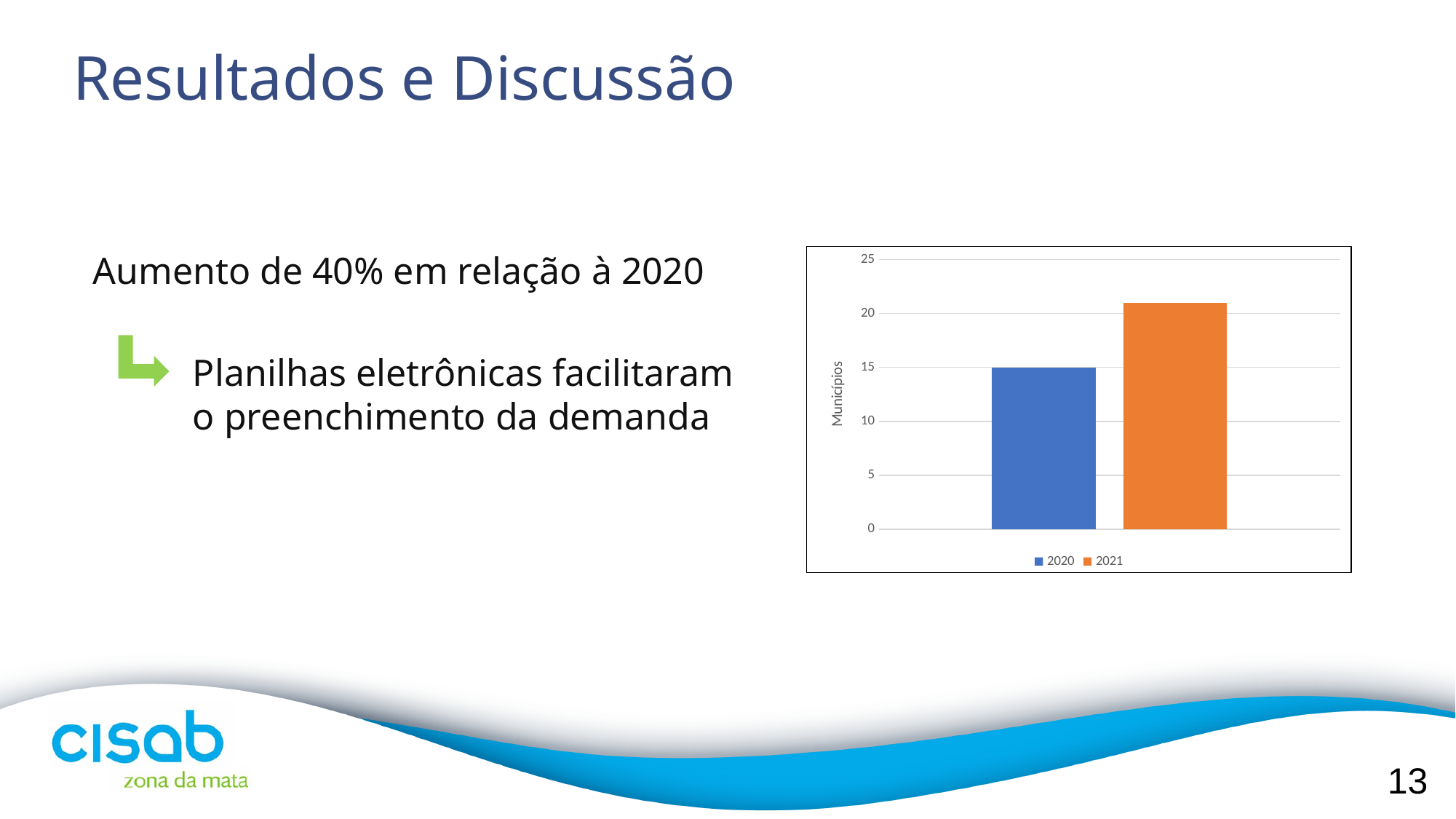
Which series has the highest bar in the chart? 2021 Is the value for 2021 greater or less than 20? greater How many bars are plotted in the chart? 2 How many series does the chart legend list? 2 What colour is the bar for 2021 in the chart? orange Which series has the lowest bar in the chart? 2020 What kind of chart is shown on the slide? bar chart Which series has the higher value, 2020 or 2021? 2021 Do the values rise or fall from 2020 to 2021? rise What is the value of the 2020 bar in the chart? 15 What is the label on the vertical axis of the chart? Municípios Is the value for 2020 greater or less than 20? less